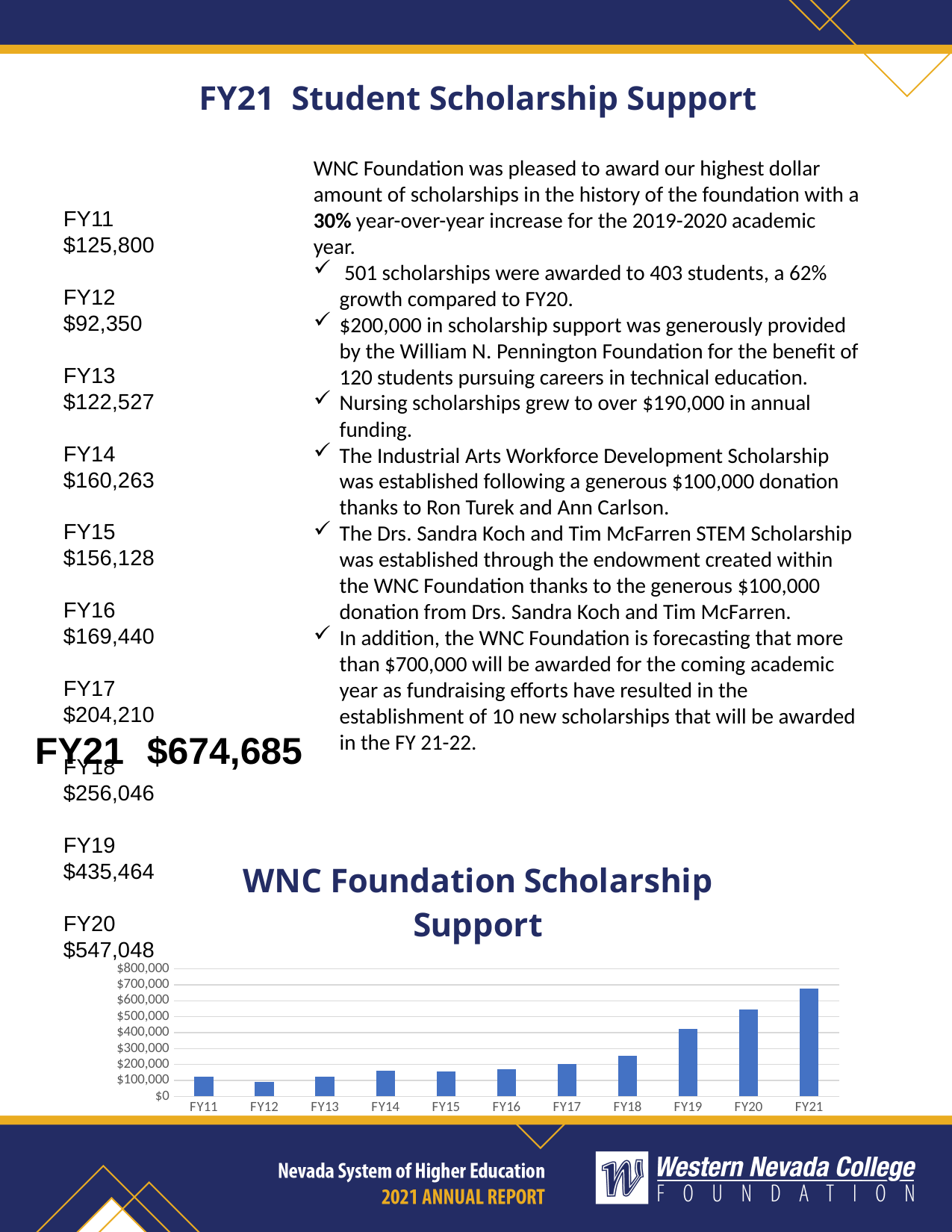
Is the value for FY20 greater or less than $500,000? greater What is the difference between the FY21 and FY20 scholarship support amounts? $127,637 What is the title of the chart? WNC Foundation Scholarship Support What kind of chart is shown on the slide? bar chart What is the scholarship support amount for FY19? $435,464 Which is larger, the value for FY19 or the value for FY17? FY19 How many fiscal years are plotted on the x axis of the chart? 11 Is the value for FY18 greater or less than $300,000? less Which fiscal year has the lowest scholarship support in the chart? FY12 What is the scholarship support amount for FY21? $674,685 Which fiscal year has the highest scholarship support in the chart? FY21 Do the values generally rise or fall from FY11 to FY21? rise